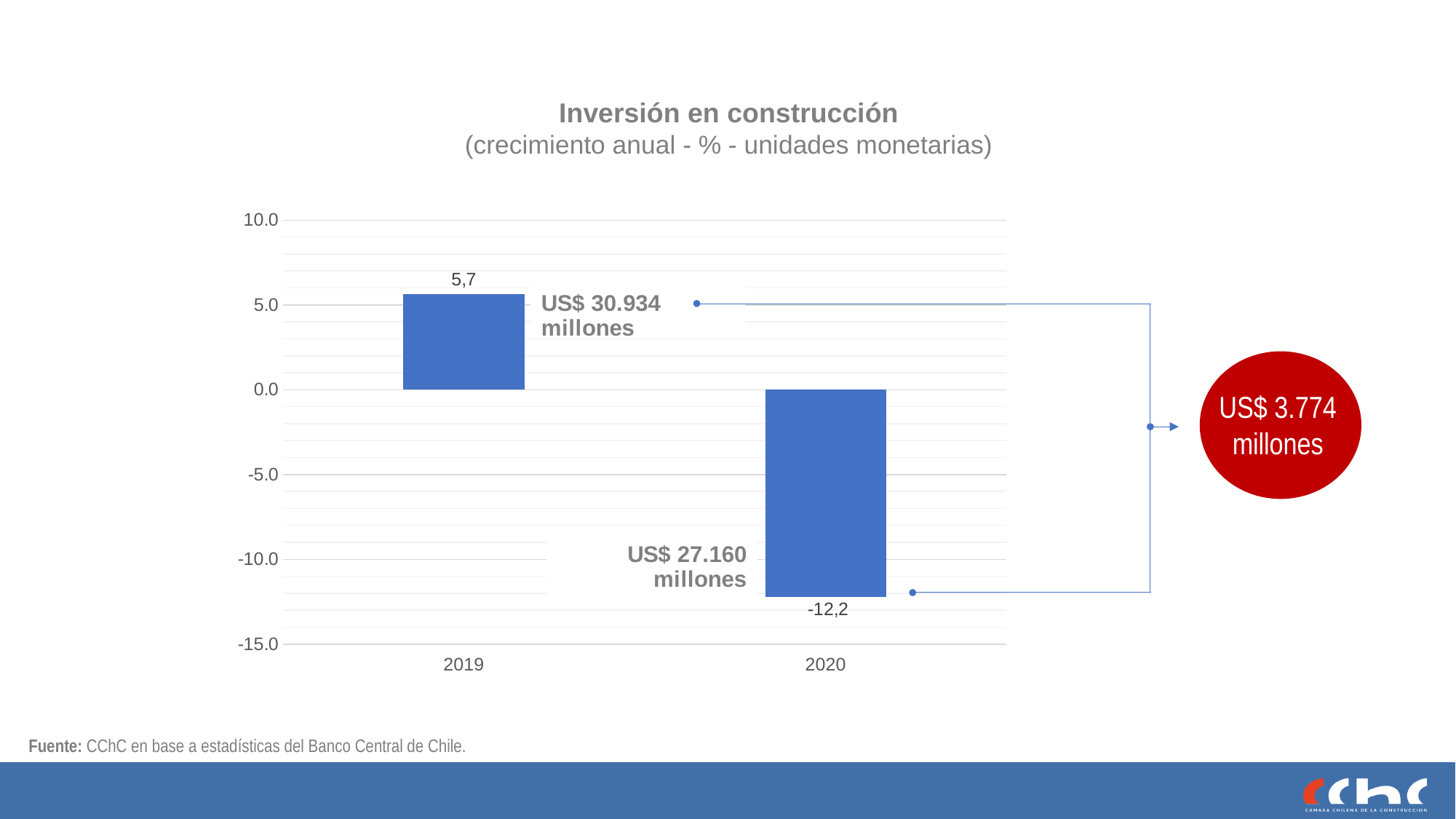
How many years are shown on the x axis? 2 Is the value for 2020 greater or less than -10.0? less What is the title of the chart? Inversión en construcción What is the value for 2019? 5,7 Which year has the highest value? 2019 Which is larger, the value for 2019 or the value for 2020? 2019 Do the values rise or fall from 2019 to 2020? fall Which year has the lowest value? 2020 What kind of chart is this? bar chart What is the difference between the values for 2019 and 2020? 17,9 What monetary amount is annotated next to the 2019 bar? US$ 30.934 millones What is the value for 2020? -12,2